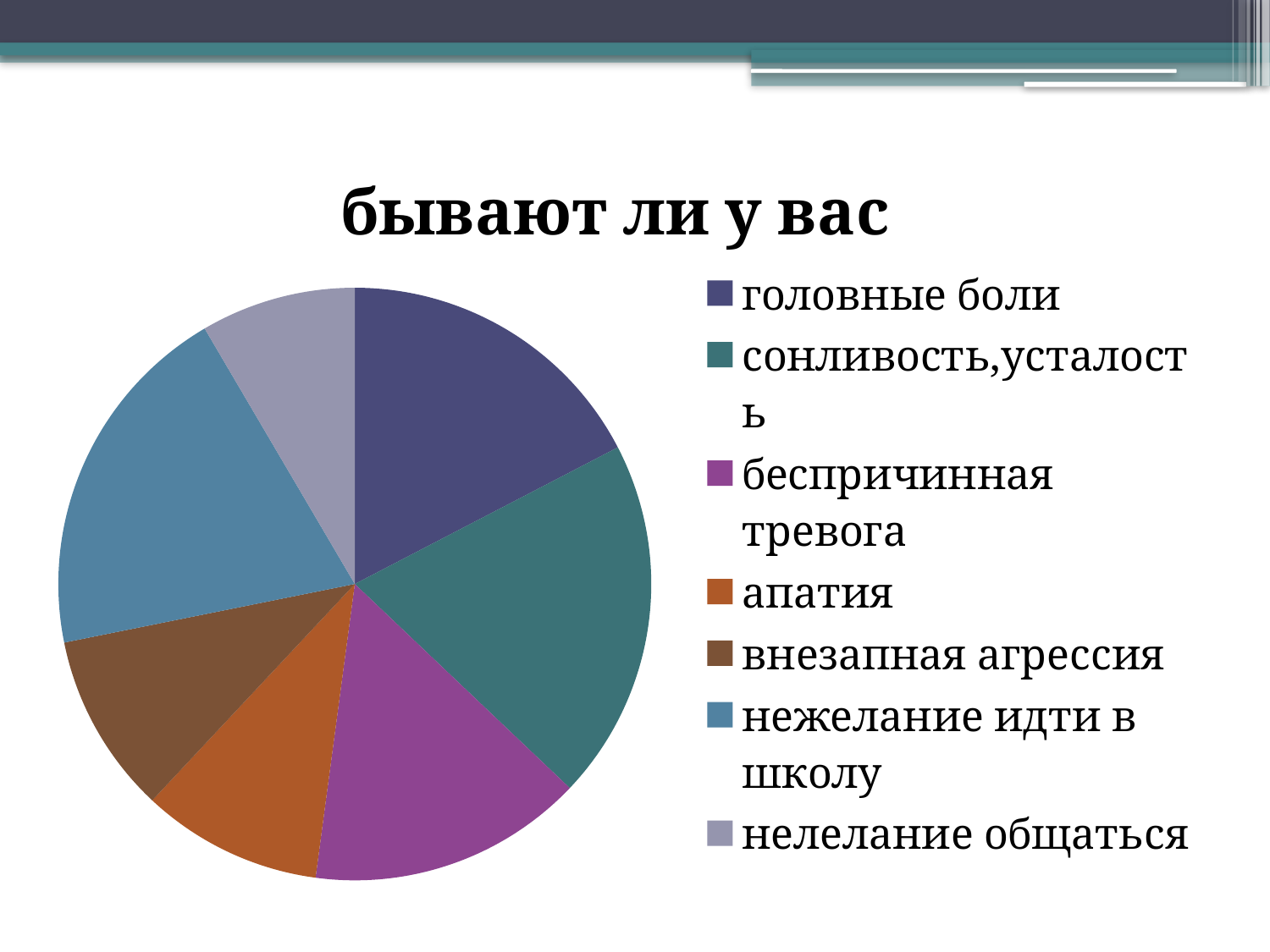
Which legend entry is listed first? головные боли Which slice is larger: сонливость,усталость or нелелание общаться? сонливость,усталость What is the title of the chart? бывают ли у вас Which slice is larger: нежелание идти в школу or апатия? нежелание идти в школу What colour is the slice for апатия? orange What kind of chart is shown on the slide? pie chart Which slice is larger: беспричинная тревога or внезапная агрессия? беспричинная тревога How many entries does the legend list? 7 How many slices does the pie chart have? 7 Which category has the smallest slice of the pie? нелелание общаться